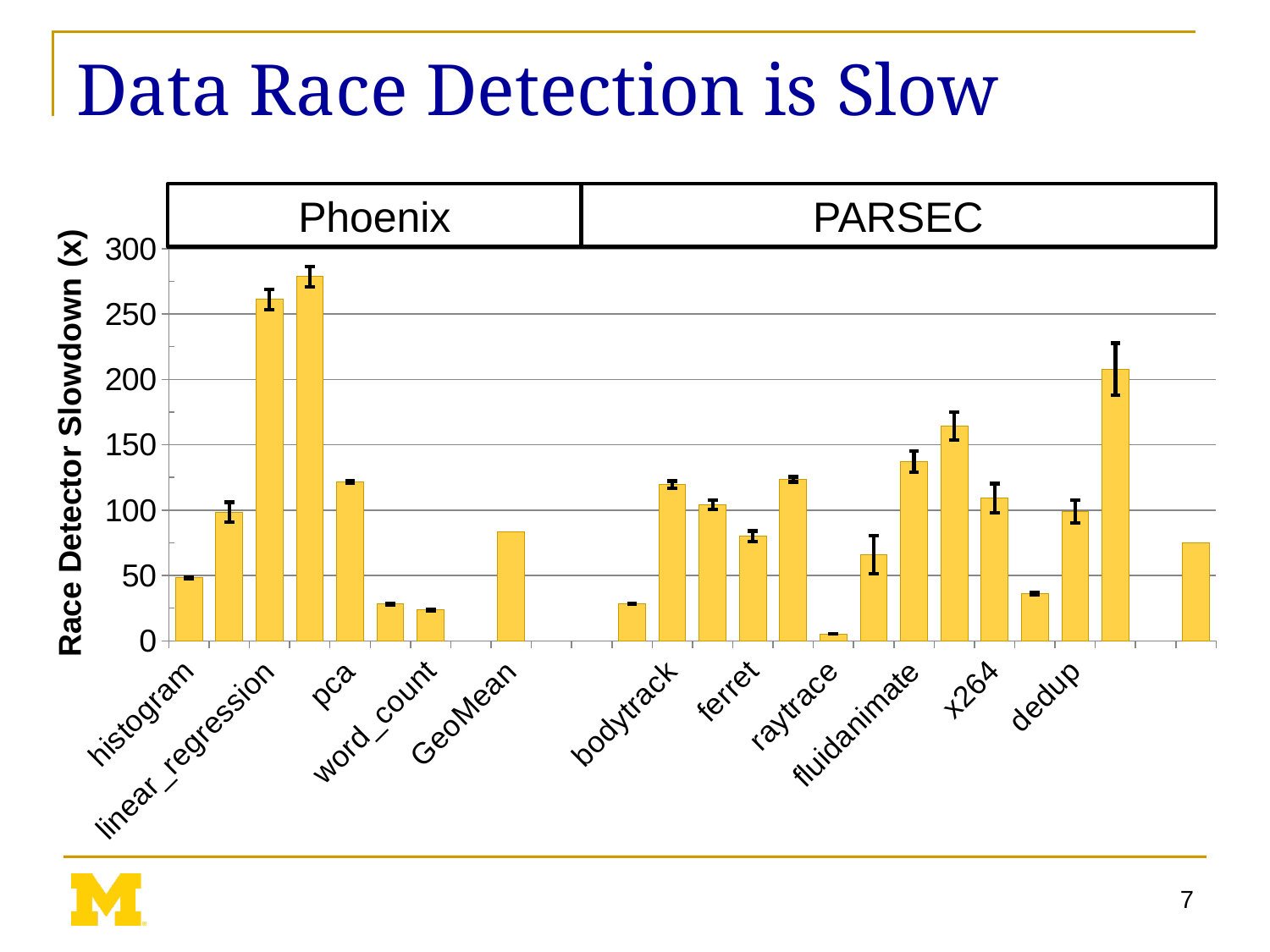
Is the value for linear_regression greater or less than 250? greater Is the value for raytrace greater or less than 50? less What are the two benchmark suite names shown in the boxes above the chart? Phoenix and PARSEC Is the value for word_count greater or less than 50? less What kind of chart is shown on the slide? bar chart Which has the larger slowdown, linear_regression or pca? linear_regression Which has the larger slowdown, fluidanimate or ferret? fluidanimate What is the label of the y axis? Race Detector Slowdown (x)